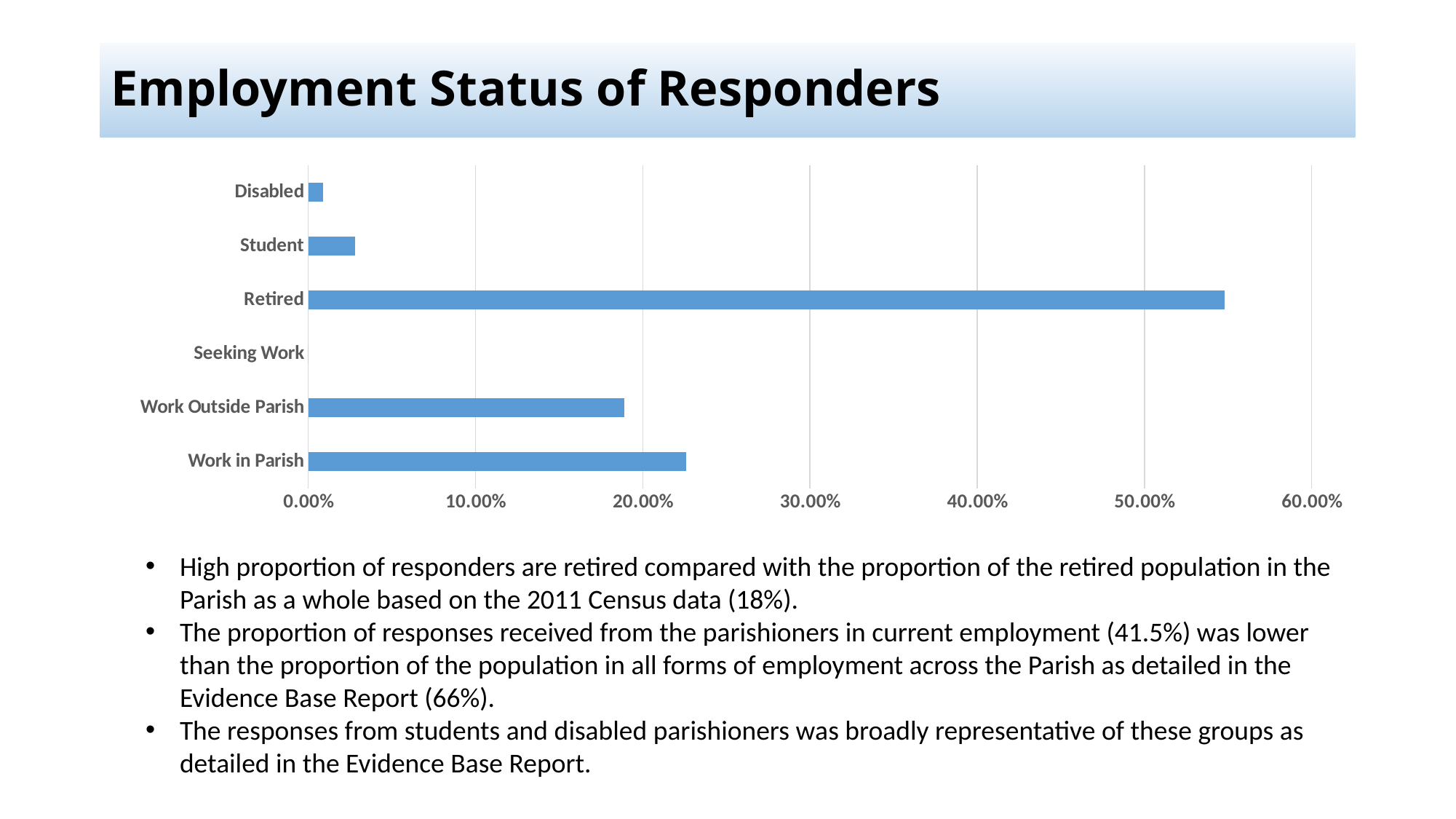
Which employment status category has the highest value in the chart? Retired What is the highest value shown on the chart's horizontal axis? 60.00% What kind of chart is shown on the slide? bar chart What is the title of the slide containing the chart? Employment Status of Responders Which employment status category has the lowest value in the chart? Seeking Work How many employment status categories are plotted in the chart? 6 Is the value for Retired greater or less than 50.00%? greater Is the value for Work Outside Parish greater or less than 20.00%? less Which is larger, the value for Work in Parish or the value for Work Outside Parish? Work in Parish Is the value for Work in Parish greater or less than 20.00%? greater Which is larger, the value for Student or the value for Disabled? Student